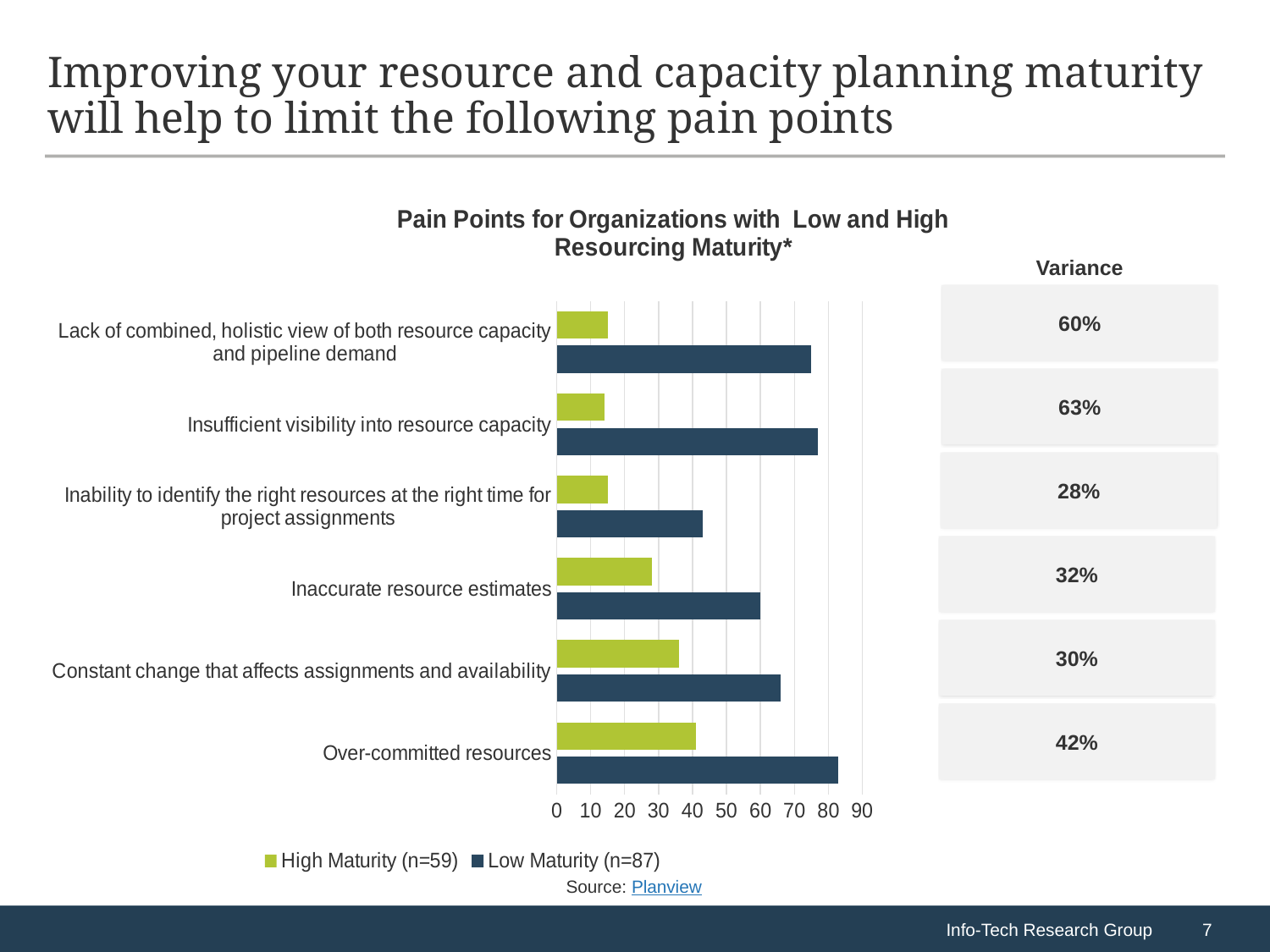
Which category has the highest High Maturity value? Over-committed resources What is the title of the chart? Pain Points for Organizations with Low and High Resourcing Maturity* For Over-committed resources, which series has the larger value, High Maturity or Low Maturity? Low Maturity How many series does the chart legend list? 2 Is the Low Maturity value for Inability to identify the right resources at the right time for project assignments greater or less than 50? less Which category has the lowest Low Maturity value? Inability to identify the right resources at the right time for project assignments Is the High Maturity value for Lack of combined, holistic view of both resource capacity and pipeline demand greater or less than 20? less Is the Low Maturity value for Over-committed resources greater or less than 70? greater What kind of chart is shown on the slide? Bar chart Which category has the highest Low Maturity value? Over-committed resources Which series is shown in green in the chart? High Maturity (n=59) How many pain point categories are plotted in the chart? 6